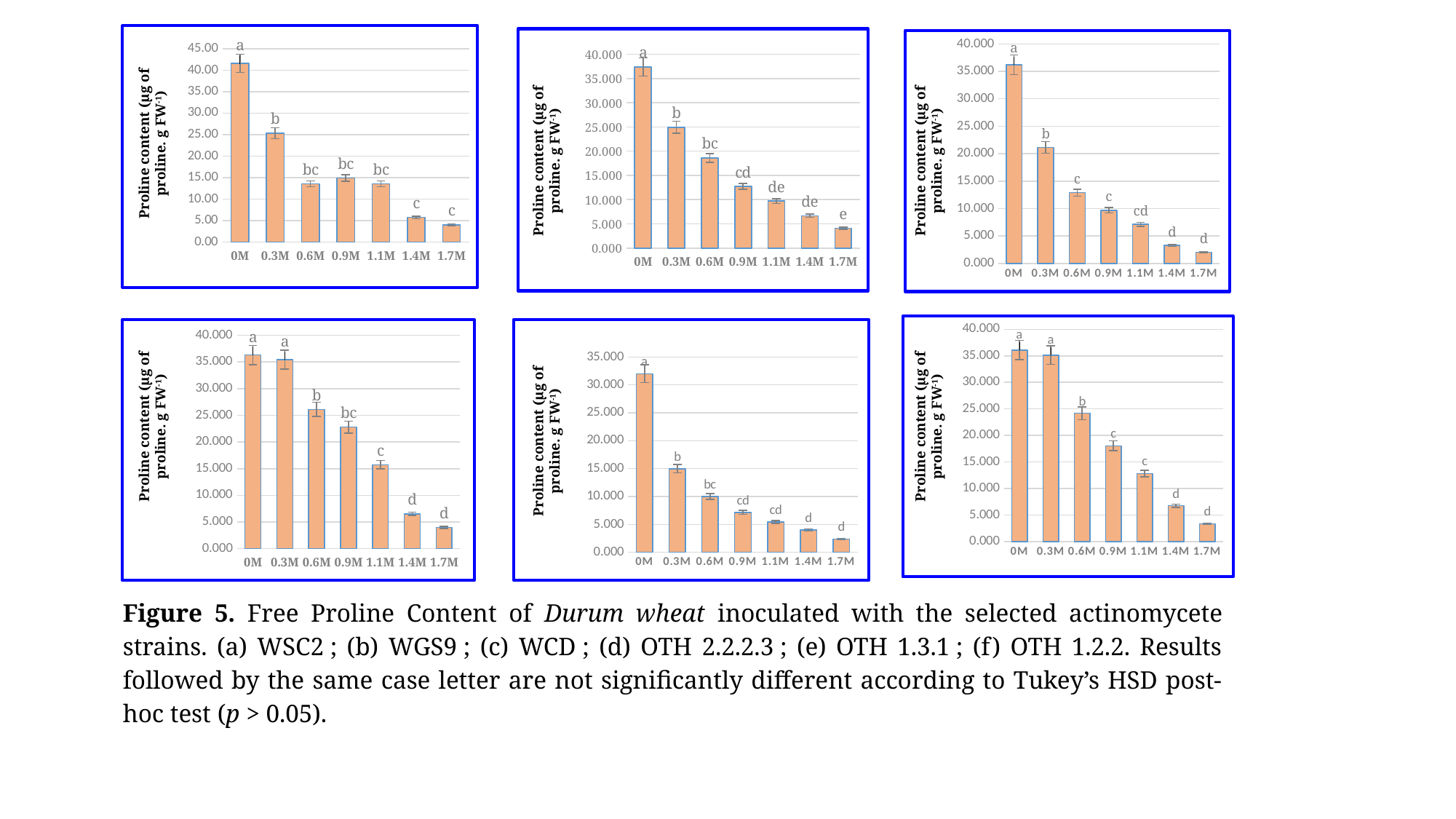
In the top-right chart, which category has the lowest proline content? 1.7M In the bottom-middle chart, do the values rise or fall as the concentration increases from 0M to 1.7M? fall How many charts are shown on the slide? 6 In the bottom-right chart, is the value for 0.9M greater or less than 15.000? greater In the top-left chart, is the value for 0M greater or less than 40.00? greater In the top-middle chart, which category has the highest proline content? 0M In the top-right chart, is the value for 1.4M greater or less than 5.000? less In the top-left chart, what significance letter is printed above the 0M bar? a In the top-left chart, which is larger, the value for 0.3M or the value for 0.6M? 0.3M How many categories are shown on the x axis of the top-left chart? 7 What kind of chart is the top-left chart? Bar chart